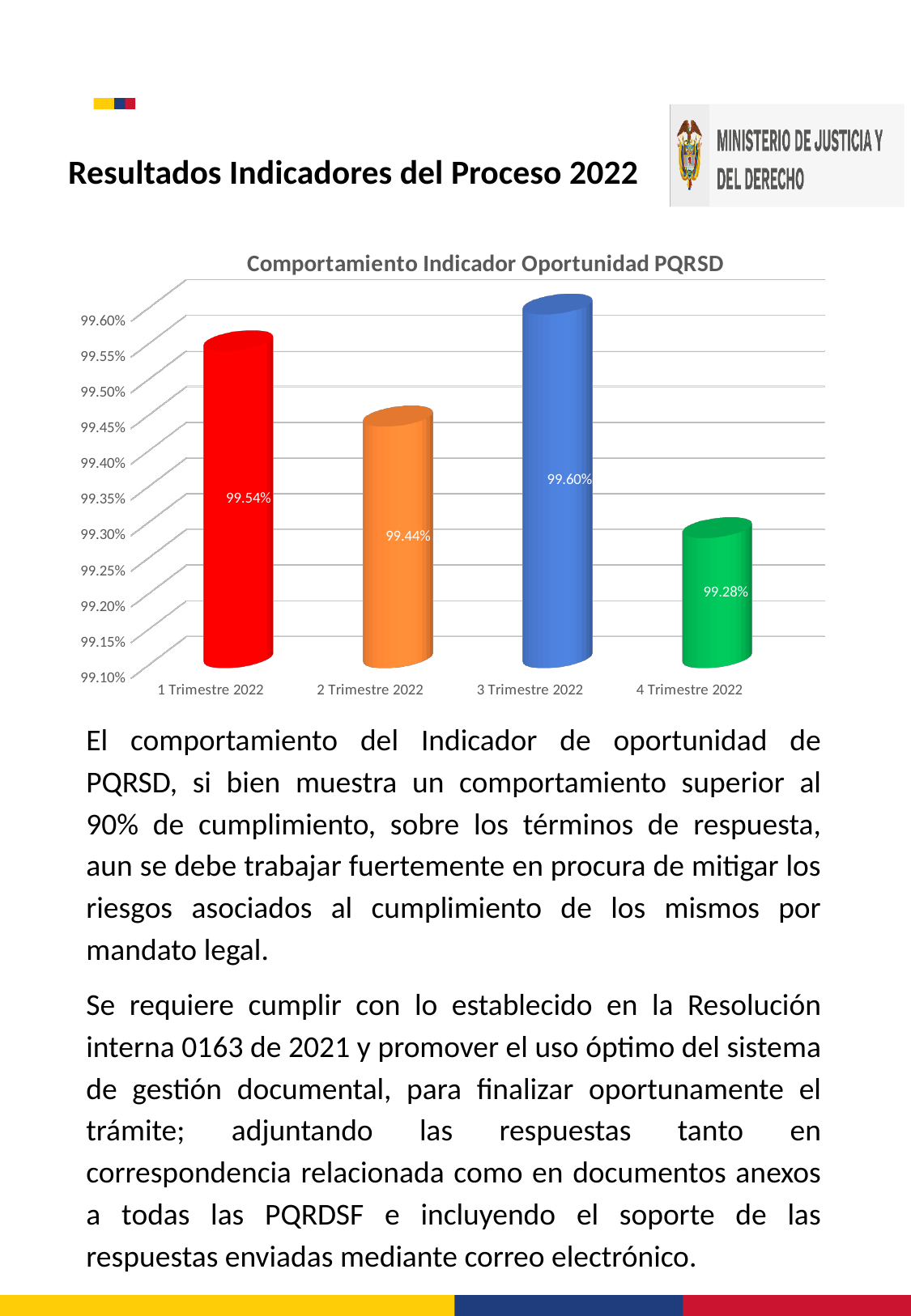
Is the value for 2 Trimestre 2022 greater or less than 99.50%? less What kind of chart is shown on the slide? Bar chart Which is larger, the value for 1 Trimestre 2022 or 2 Trimestre 2022? 1 Trimestre 2022 What is the title of the chart? Comportamiento Indicador Oportunidad PQRSD What is the value for 1 Trimestre 2022 in the Comportamiento Indicador Oportunidad PQRSD chart? 99.54% What is the difference between the values for 3 Trimestre 2022 and 4 Trimestre 2022? 0.32 percentage points What is the value for 3 Trimestre 2022? 99.60% What is the value for 2 Trimestre 2022? 99.44% What is the value for 4 Trimestre 2022? 99.28% Which quarter has the highest value in the chart? 3 Trimestre 2022 Which quarter has the lowest value in the chart? 4 Trimestre 2022 How many quarters are shown on the x axis of the chart? 4